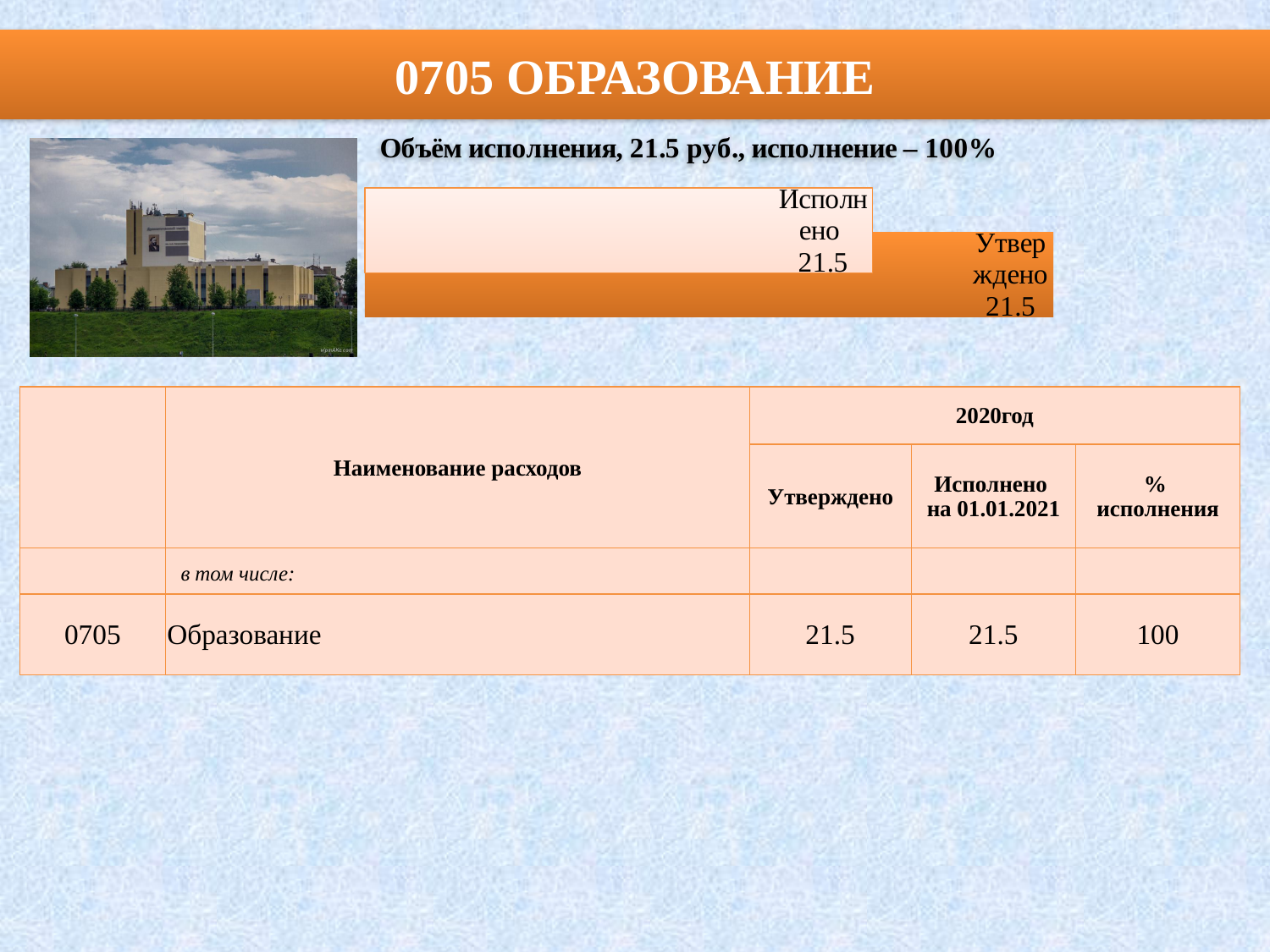
Are the bars in the chart horizontal or vertical? horizontal Is the value for Исполнено greater or less than 20? greater How many bars does the chart show? 2 What is the difference between the Утверждено and Исполнено values in the chart? 0 What is the value of the bar labelled Исполнено? 21.5 What kind of chart is shown on the slide? bar chart Which bar in the chart is drawn in dark orange? Утверждено What is the value of the bar labelled Утверждено? 21.5